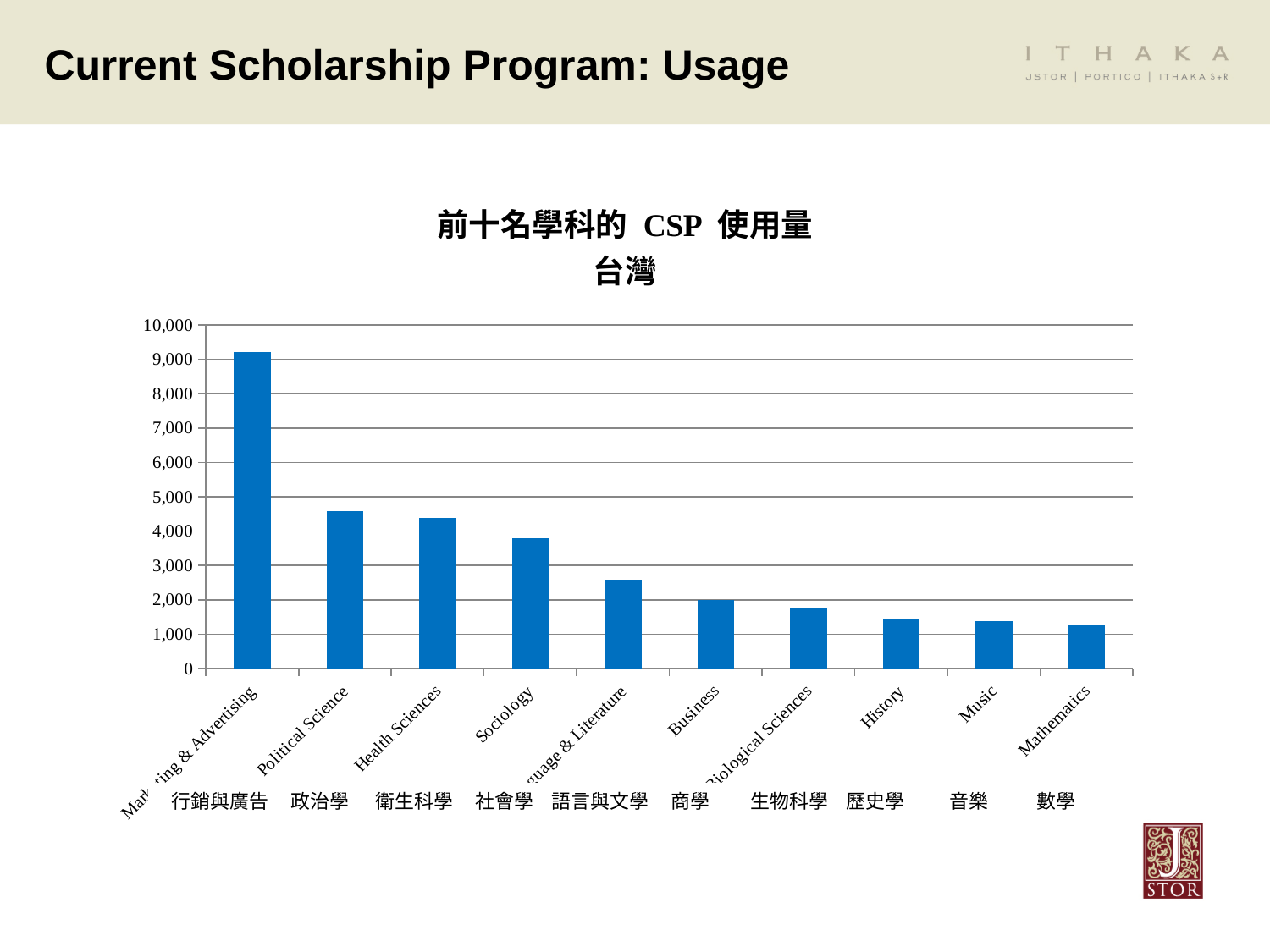
How many subject categories are plotted in the chart? 10 Which subject has the highest CSP usage in the chart? Marketing & Advertising Is the value for Political Science greater or less than 4,000? greater Is the value for History greater or less than 2,000? less Is the value for Marketing & Advertising greater or less than 8,000? greater Which has a larger value, Political Science or History? Political Science What is the maximum value shown on the vertical axis of the chart? 10,000 Do the values rise or fall moving from left to right along the x axis? fall Which has a larger value, Health Sciences or Sociology? Health Sciences What kind of chart is shown on the slide? bar chart